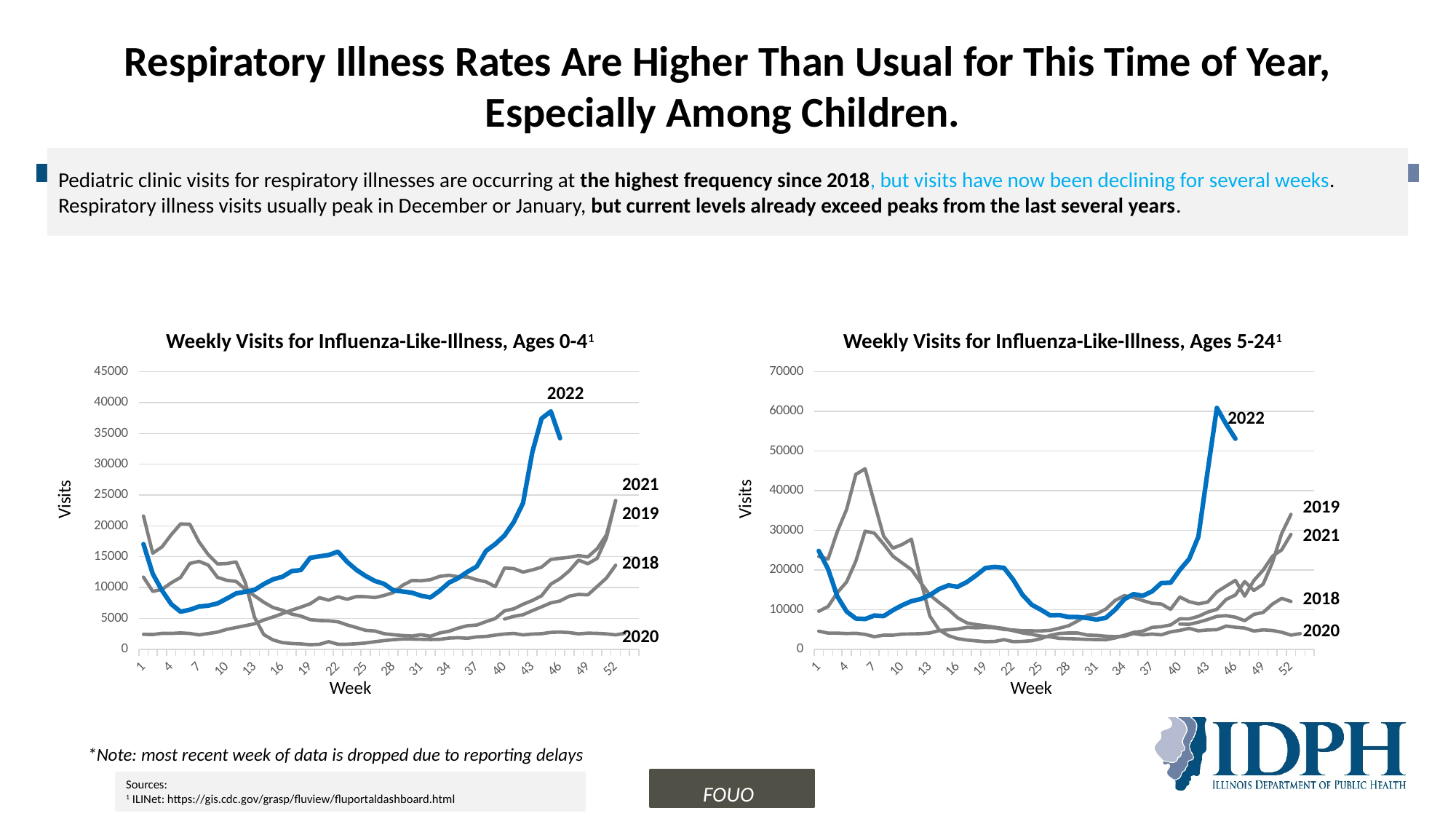
On the right chart (Ages 5-24), is the peak value for 2022 greater or less than 50000? greater What kind of chart is the left chart, 'Weekly Visits for Influenza-Like-Illness, Ages 0-4'? Line chart How many year series are plotted on the right chart, 'Weekly Visits for Influenza-Like-Illness, Ages 5-24'? 5 What is the label on the x axis of both charts? Week On the left chart (Ages 0-4), is the peak value for 2022 greater or less than 35000? greater On the right chart (Ages 5-24), at week 52, which year has more visits: 2019 or 2018? 2019 On the left chart (Ages 0-4), at week 52, which year has more visits: 2021 or 2018? 2021 On the left chart (Ages 0-4), which year reaches the highest peak in weekly visits? 2022 On the right chart (Ages 5-24), do the 2022 visits rise or fall over the last few weeks plotted? Fall On the right chart (Ages 5-24), is the peak value for 2019 greater or less than 40000? less